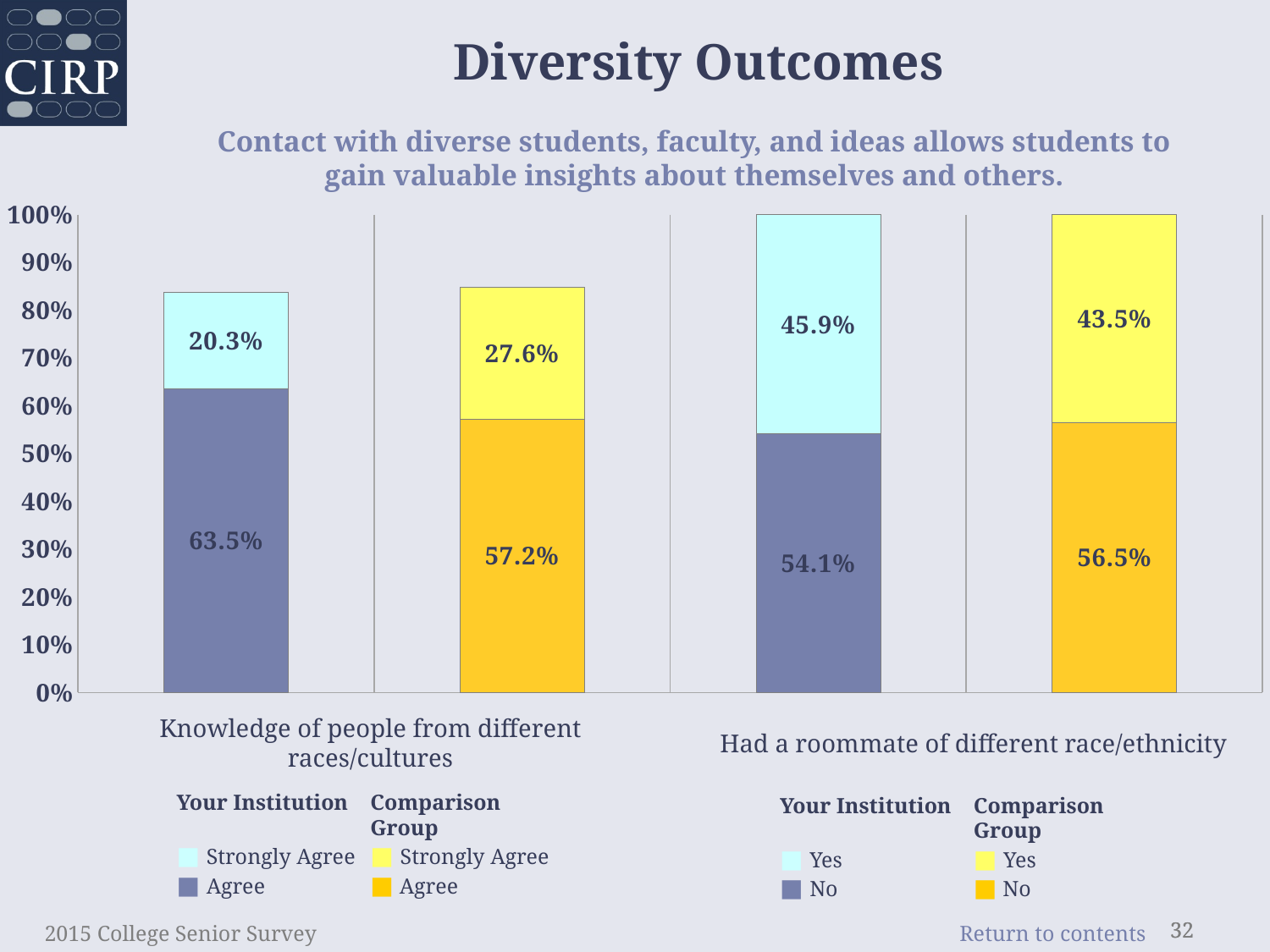
What kind of chart is used on this slide? Stacked bar chart How many bars are shown in the 'Had a roommate of different race/ethnicity' chart? 2 In the 'Had a roommate of different race/ethnicity' chart, which group has the larger Yes percentage, Your Institution or the Comparison Group? Your Institution In the 'Had a roommate of different race/ethnicity' chart, what percentage of the Comparison Group answered No? 56.5% In the 'Had a roommate of different race/ethnicity' chart, what is the difference between the Yes percentages for Your Institution and the Comparison Group? 2.4% In the 'Knowledge of people from different races/cultures' chart, what is the total of the Your Institution stacked bar (Strongly Agree plus Agree)? 83.8% In the 'Knowledge of people from different races/cultures' chart, what percentage of the Comparison Group answered Strongly Agree? 27.6% In the 'Had a roommate of different race/ethnicity' chart, what percentage of Your Institution students answered Yes? 45.9% In the 'Knowledge of people from different races/cultures' chart, what is the difference between the Agree percentages for Your Institution and the Comparison Group? 6.3% In the 'Knowledge of people from different races/cultures' chart, what is the total of the Comparison Group stacked bar (Strongly Agree plus Agree)? 84.8% In the 'Knowledge of people from different races/cultures' chart, what percentage of Your Institution students answered Agree? 63.5% In the 'Knowledge of people from different races/cultures' chart, which group has the larger Strongly Agree percentage, Your Institution or the Comparison Group? Comparison Group